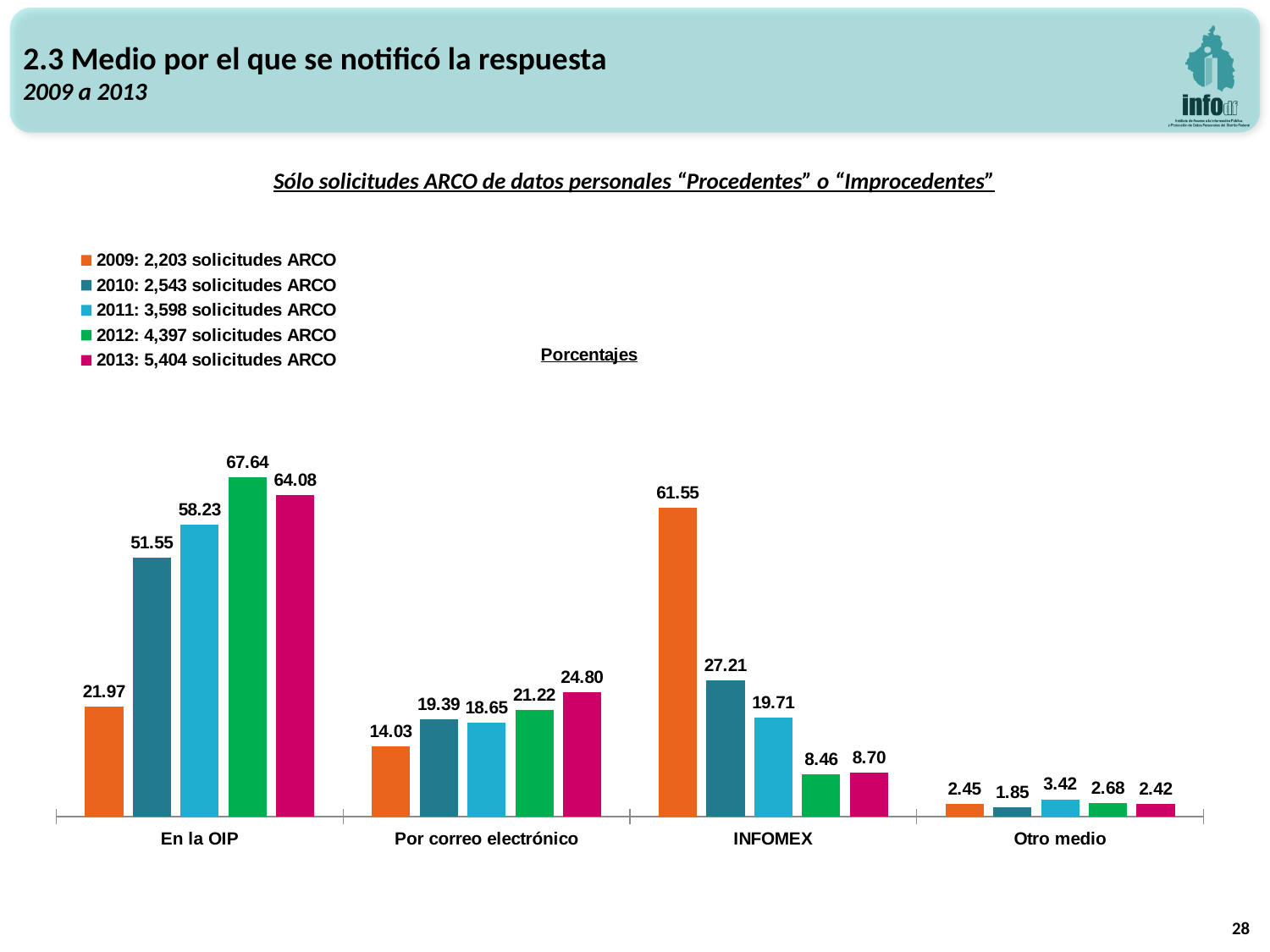
How many categories are shown on the x axis? 4 Which year has the lowest value in the INFOMEX category? 2012 What is the value for 2013 in the 'Por correo electrónico' category? 24.80 What is the value for 2009 in the INFOMEX category? 61.55 What kind of chart is shown on the slide? Bar chart Which year has the highest value in the 'En la OIP' category? 2012 What is the value for 2012 in the 'En la OIP' category? 67.64 Which legend entry is shown in orange? 2009: 2,203 solicitudes ARCO What is the difference between the 2012 and 2009 values in the 'En la OIP' category? 45.67 Which is larger in the 'Por correo electrónico' category: the 2010 value or the 2011 value? 2010 What is the value for 2010 in the 'Otro medio' category? 1.85 How many series does the legend list? 5